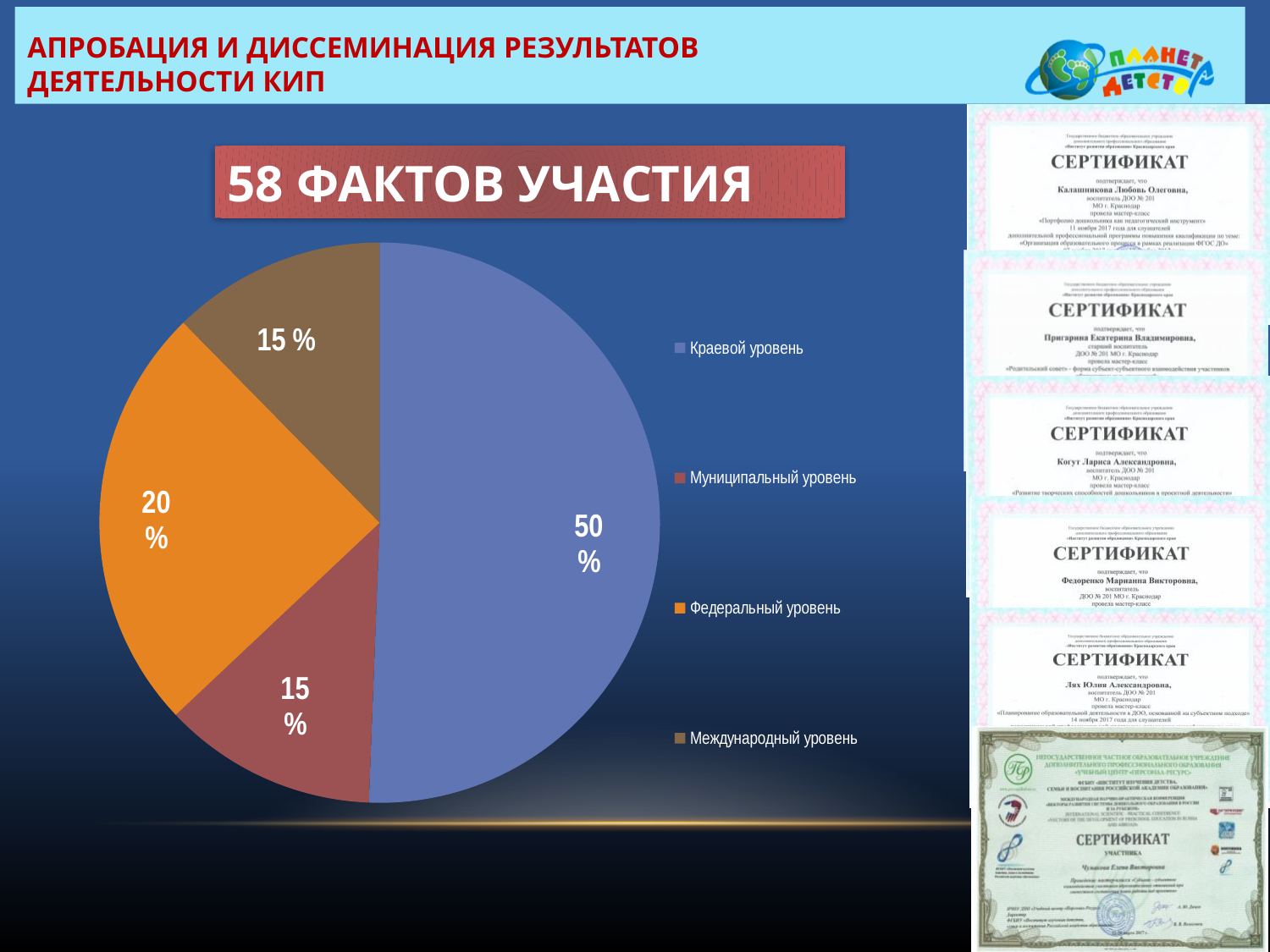
What kind of chart is shown on the slide? pie chart How many slices does the pie chart have? 4 Which is larger, the slice for Федеральный уровень or the slice for Международный уровень? Федеральный уровень What colour is the slice for Федеральный уровень? orange What is the heading printed above the pie chart? 58 ФАКТОВ УЧАСТИЯ What is the difference in percentage points between Краевой уровень and Федеральный уровень? 30 Which category has the largest slice of the pie? Краевой уровень What share of the pie does Международный уровень have? 15 % What share of the pie does Муниципальный уровень have? 15 % How many entries does the legend list? 4 What share of the pie does Федеральный уровень have? 20 % What share of the pie does Краевой уровень have? 50 %